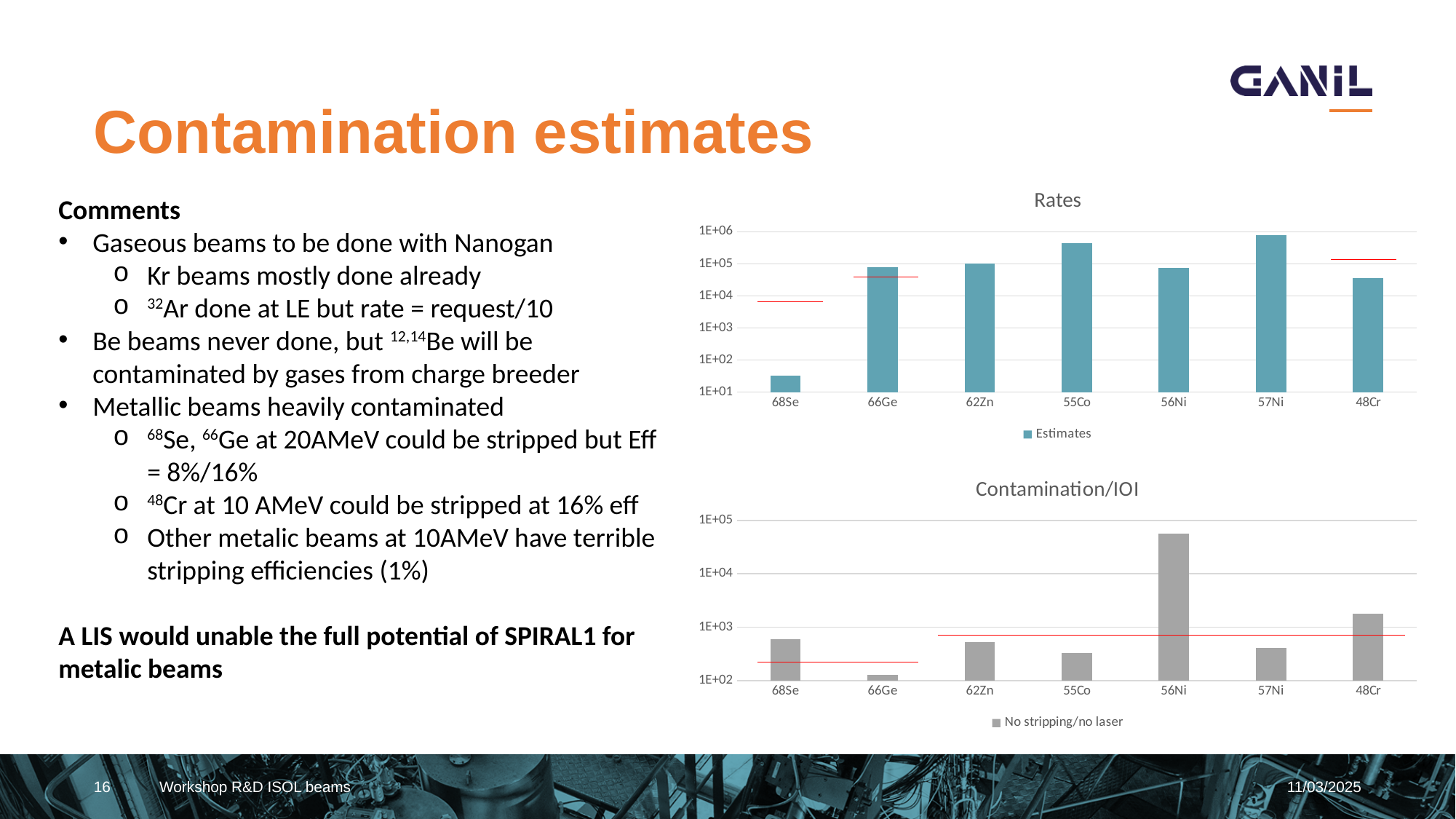
What is the legend entry of the Contamination/IOI chart? No stripping/no laser In the Rates chart, which category has the lowest bar? 68Se In the Contamination/IOI chart, is the value for 56Ni greater or less than 1E+04? greater In the Contamination/IOI chart, which is larger, the value for 48Cr or the value for 55Co? 48Cr In the Rates chart, which category has the highest bar? 57Ni In the Rates chart, is the value for 57Ni greater or less than 1E+05? greater In the Contamination/IOI chart, which category has the lowest bar? 66Ge In the Rates chart, which is larger, the value for 57Ni or the value for 48Cr? 57Ni In the Rates chart, is the value for 68Se greater or less than 1E+02? less In the Contamination/IOI chart, which category has the highest bar? 56Ni How many categories are shown on the x axis of the Rates chart? 7